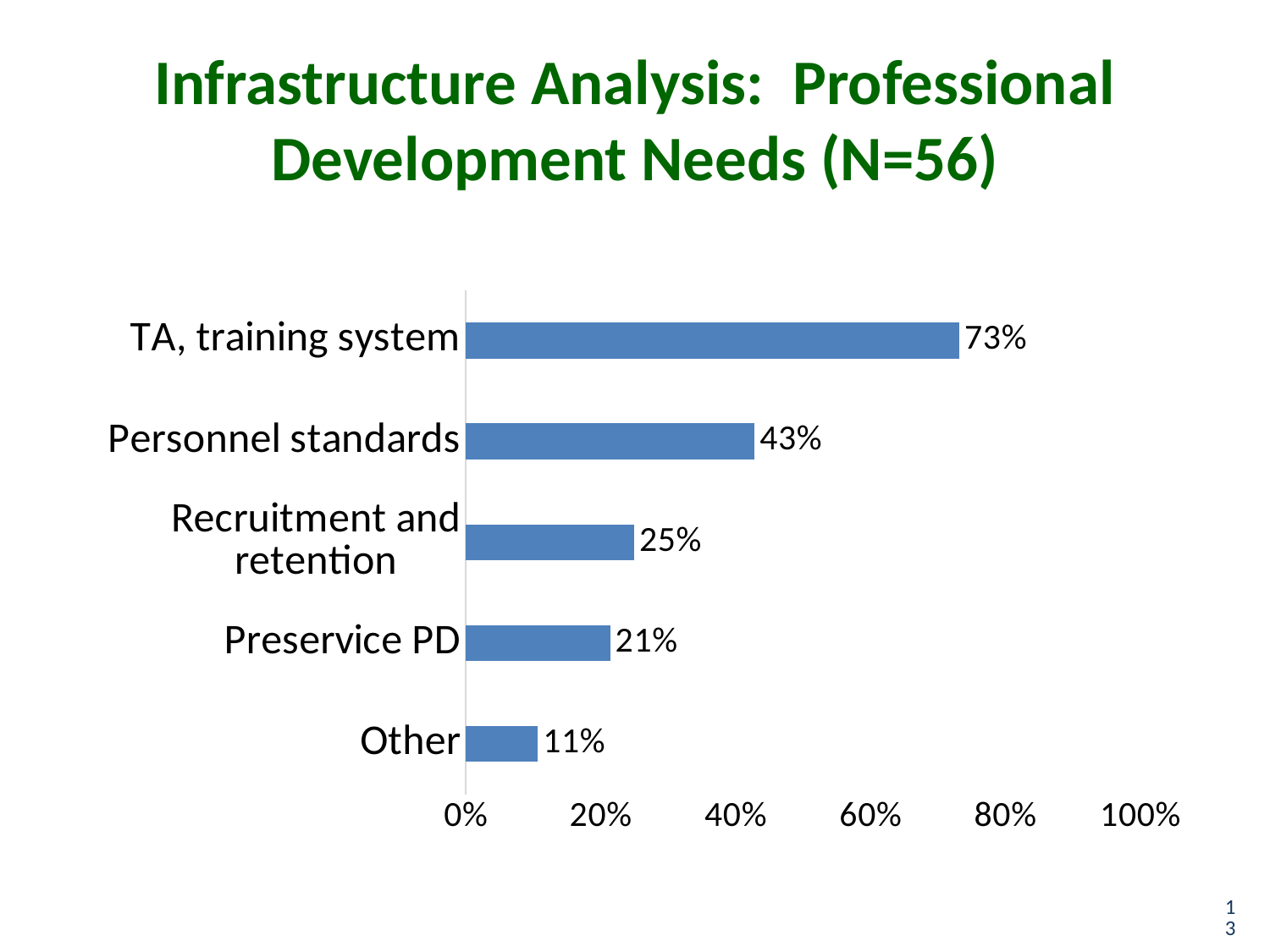
What is the value for Preservice PD? 21% What kind of chart is shown on the slide? Bar chart Which category has the lowest value? Other Which is larger, the value for Recruitment and retention or the value for Preservice PD? Recruitment and retention What is the value for Personnel standards? 43% What is the value for Other? 11% What is the title of the slide containing the chart? Infrastructure Analysis: Professional Development Needs (N=56) What is the difference between the values for TA, training system and Personnel standards? 30% How many categories are shown in the chart? 5 What is the value for Recruitment and retention? 25% Which category has the highest value? TA, training system What is the value for TA, training system? 73%